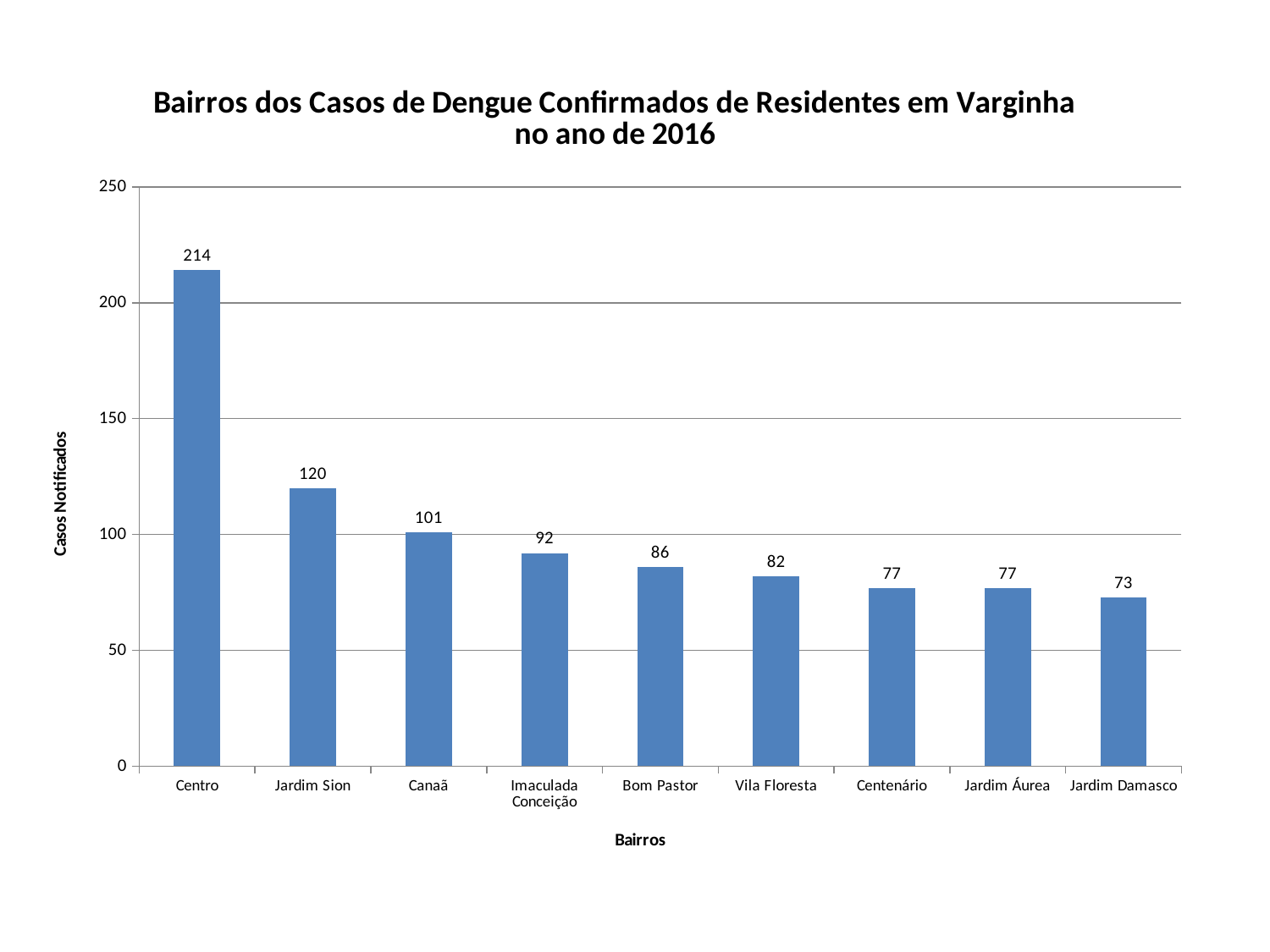
Which bairro has the highest number of cases? Centro What is the difference between the values for Centro and Jardim Sion? 94 Is the value for Canaã greater or less than 100? greater What is the value for Imaculada Conceição? 92 What is the difference between the values for Canaã and Jardim Damasco? 28 How many confirmed dengue cases are shown for Centro? 214 Which has a larger value, Bom Pastor or Vila Floresta? Bom Pastor How many bairros are shown on the x axis? 9 What kind of chart is this? Bar chart Which bairro has the lowest number of cases? Jardim Damasco Do the values rise or fall from left to right along the x axis? Fall What is the value for Jardim Sion? 120